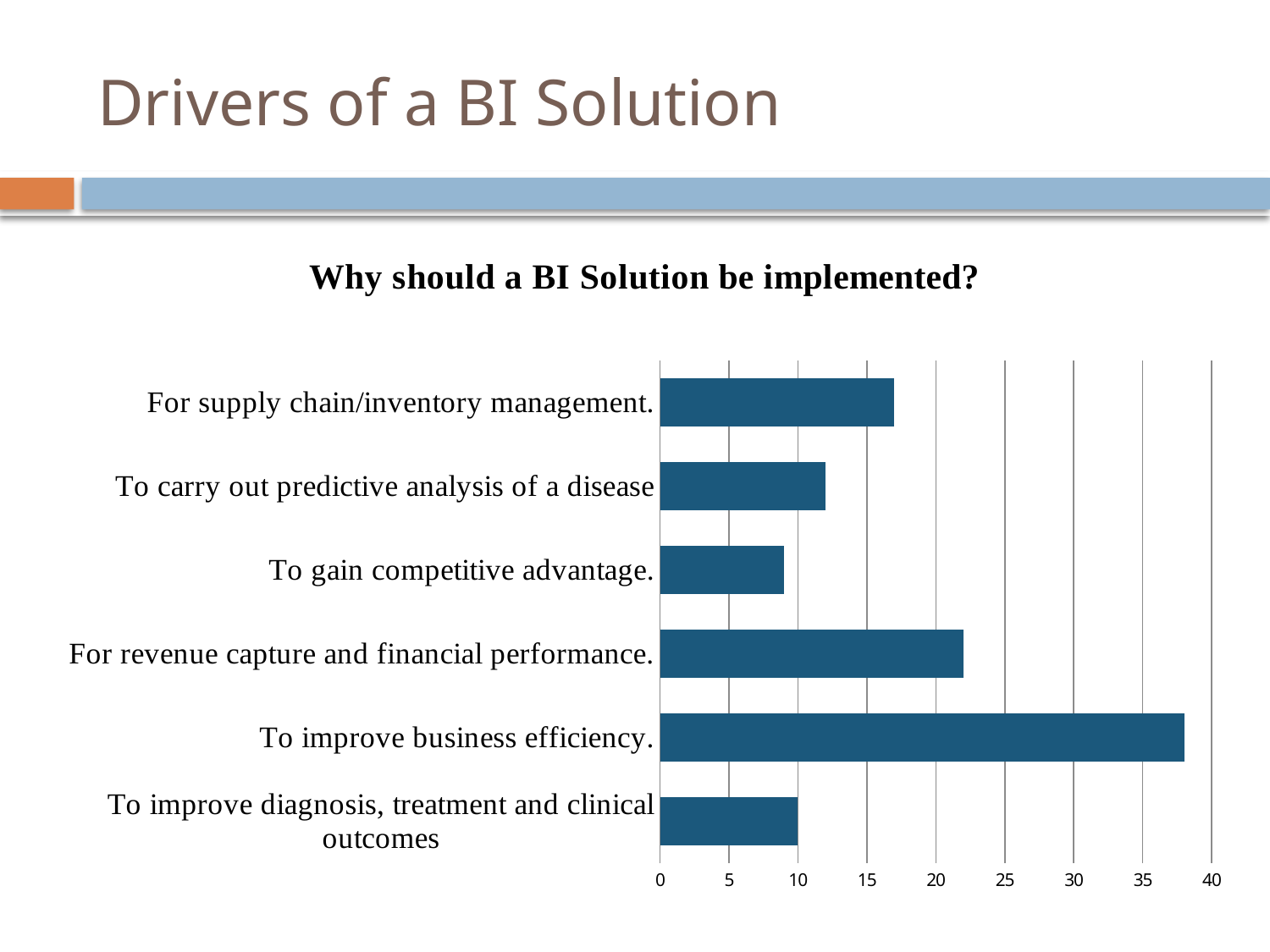
How many categories (bars) does the chart show? 6 Is the value for "To gain competitive advantage." greater or less than 10? less Is the value for "For supply chain/inventory management." greater or less than 15? greater Is the value for "To improve business efficiency." greater or less than 35? greater What kind of chart is shown on the slide? bar chart What is the maximum value shown on the horizontal axis? 40 What is the title of the chart? Why should a BI Solution be implemented? Which has a larger value: "For supply chain/inventory management." or "To carry out predictive analysis of a disease"? For supply chain/inventory management. Which has a larger value: "For revenue capture and financial performance." or "To improve business efficiency."? To improve business efficiency. Which category has the highest value? To improve business efficiency.